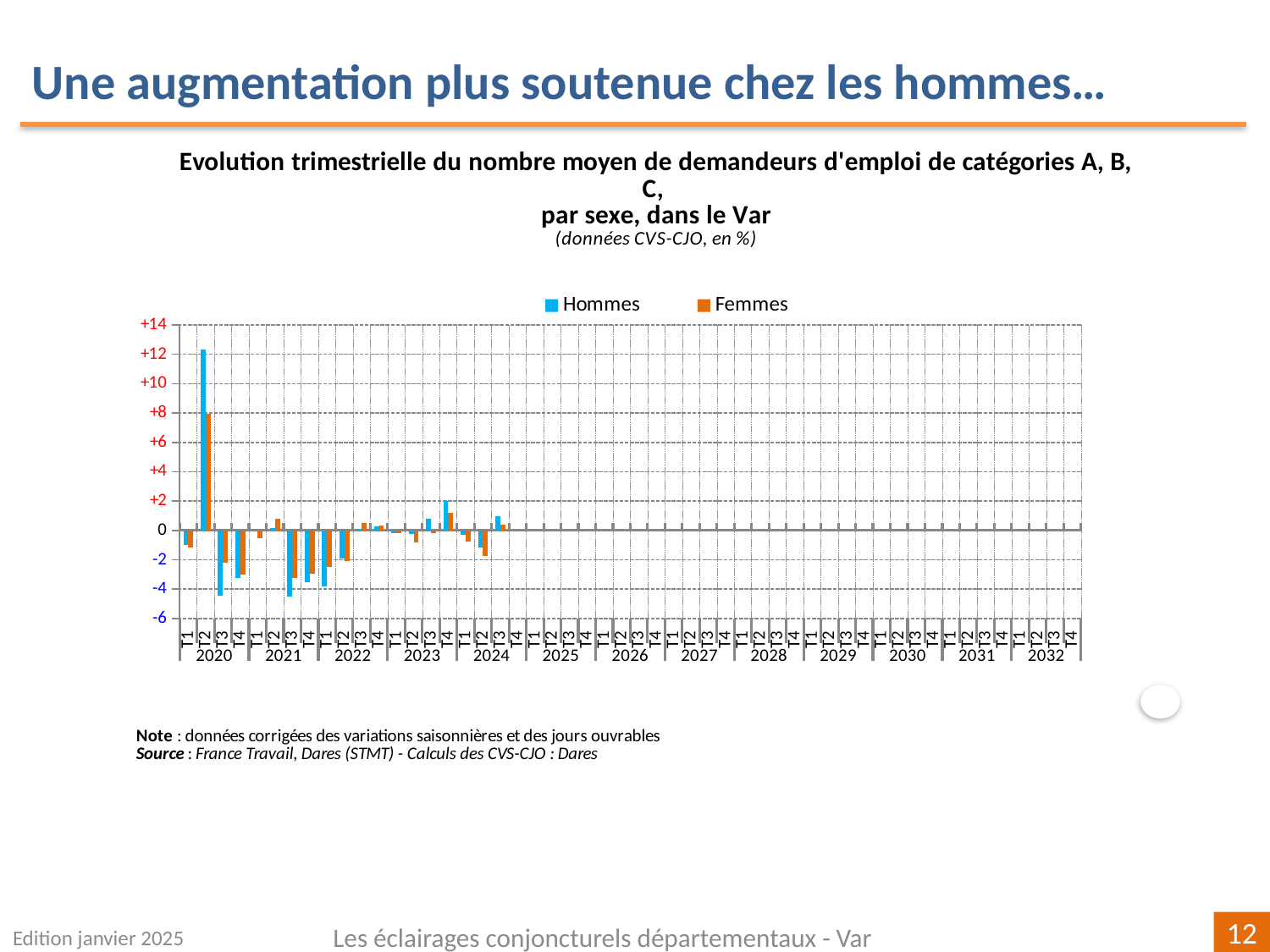
Which colour represents the Hommes series? blue Is the value for Hommes in T3 2020 greater or less than -2? less Which two series are listed in the legend? Hommes and Femmes In T4 2020, which series has the lower value, Hommes or Femmes? Hommes In T2 2020, which series has the larger value, Hommes or Femmes? Hommes What kind of chart is shown on the slide? bar chart How many years are labelled along the x axis? 13 How many series does the legend list? 2 In which quarter does the Femmes series reach its highest value? T2 2020 Is the value for Femmes in T2 2020 greater or less than +6? greater In which quarter does the Hommes series reach its highest value? T2 2020 Is the value for Hommes in T2 2020 greater or less than +10? greater